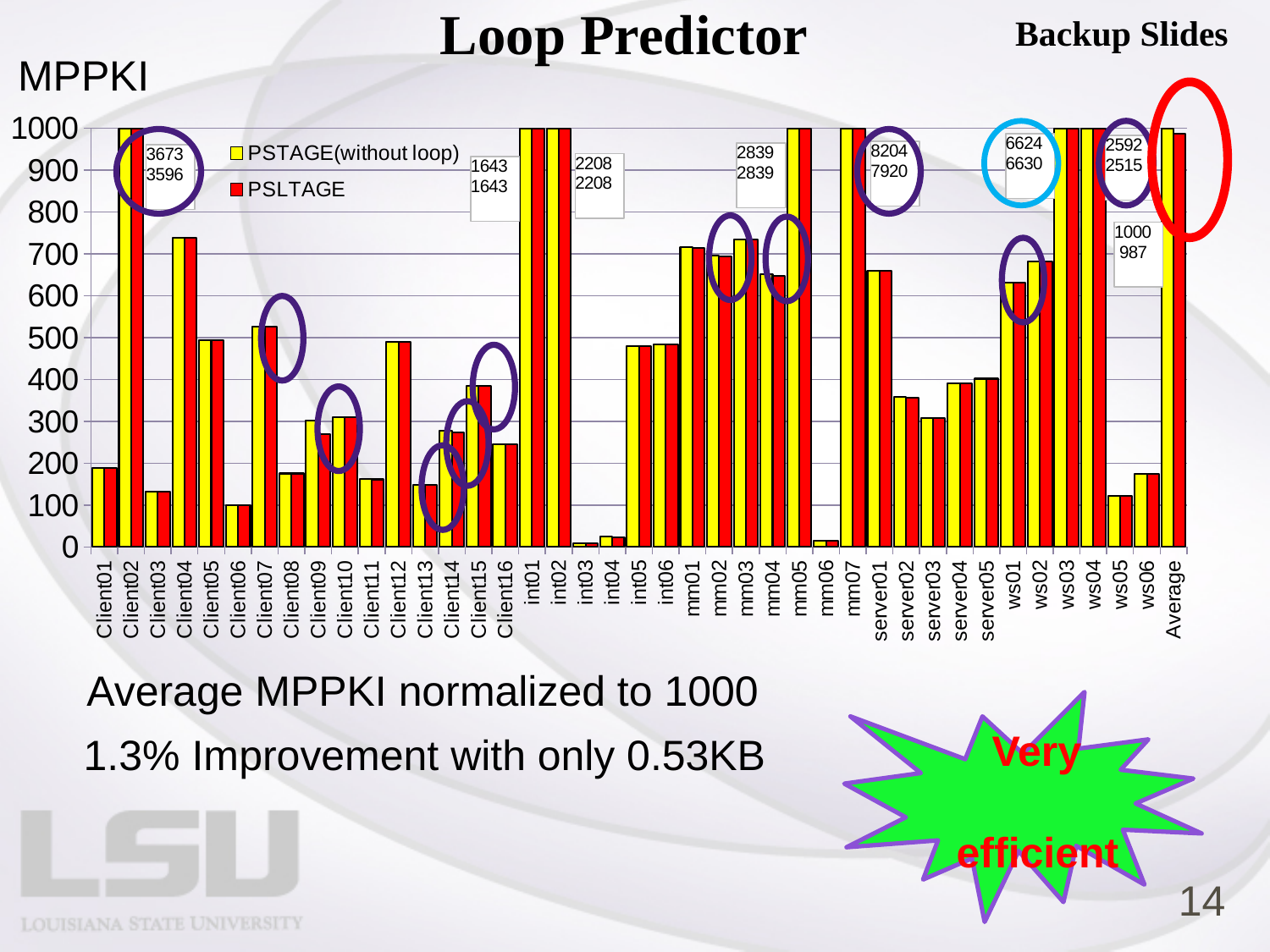
Is the PSTAGE(without loop) value for Client04 greater or less than 700? greater What are the two series named in the legend? PSTAGE(without loop) and PSLTAGE How many categories are shown on the x axis? 41 What is the label shown above the y axis? MPPKI Is the PSLTAGE value for server01 greater or less than 600? greater What is the difference between the PSTAGE(without loop) and PSLTAGE values for Average? 13 Which category has the lowest values? int03 What is the PSLTAGE value for Average? 987 What is the PSTAGE(without loop) value for Average? 1000 What kind of chart is shown on the slide? bar chart How many series does the legend list? 2 Which is larger for Client09, the PSTAGE(without loop) value or the PSLTAGE value? PSTAGE(without loop)